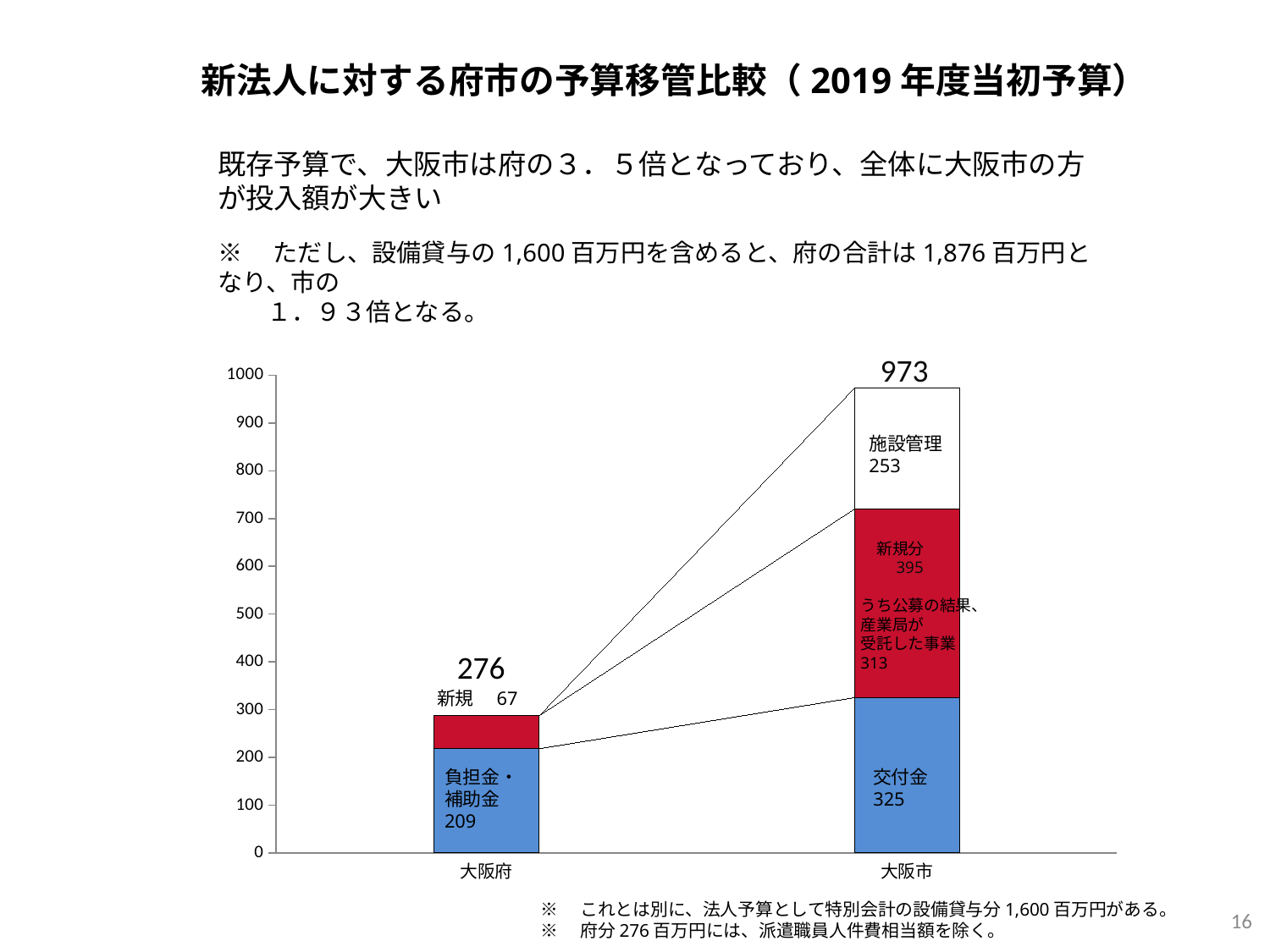
What is the value of the 交付金 segment in the 大阪市 bar? 325 How many categories are shown on the x axis? 2 Is the total for 大阪府 greater or less than 300? less What is the difference between the 交付金 segment of 大阪市 and the 負担金・補助金 segment of 大阪府? 116 What is the value of the 施設管理 segment in the 大阪市 bar? 253 What kind of chart is shown on the slide? Stacked bar chart What is the value of the 負担金・補助金 segment in the 大阪府 bar? 209 What is the total value shown above the bar for 大阪市? 973 What is the total value shown above the bar for 大阪府? 276 Which category has the higher total, 大阪府 or 大阪市? 大阪市 What is the value of the 新規 segment in the 大阪府 bar? 67 What is the difference between the totals for 大阪市 and 大阪府? 697